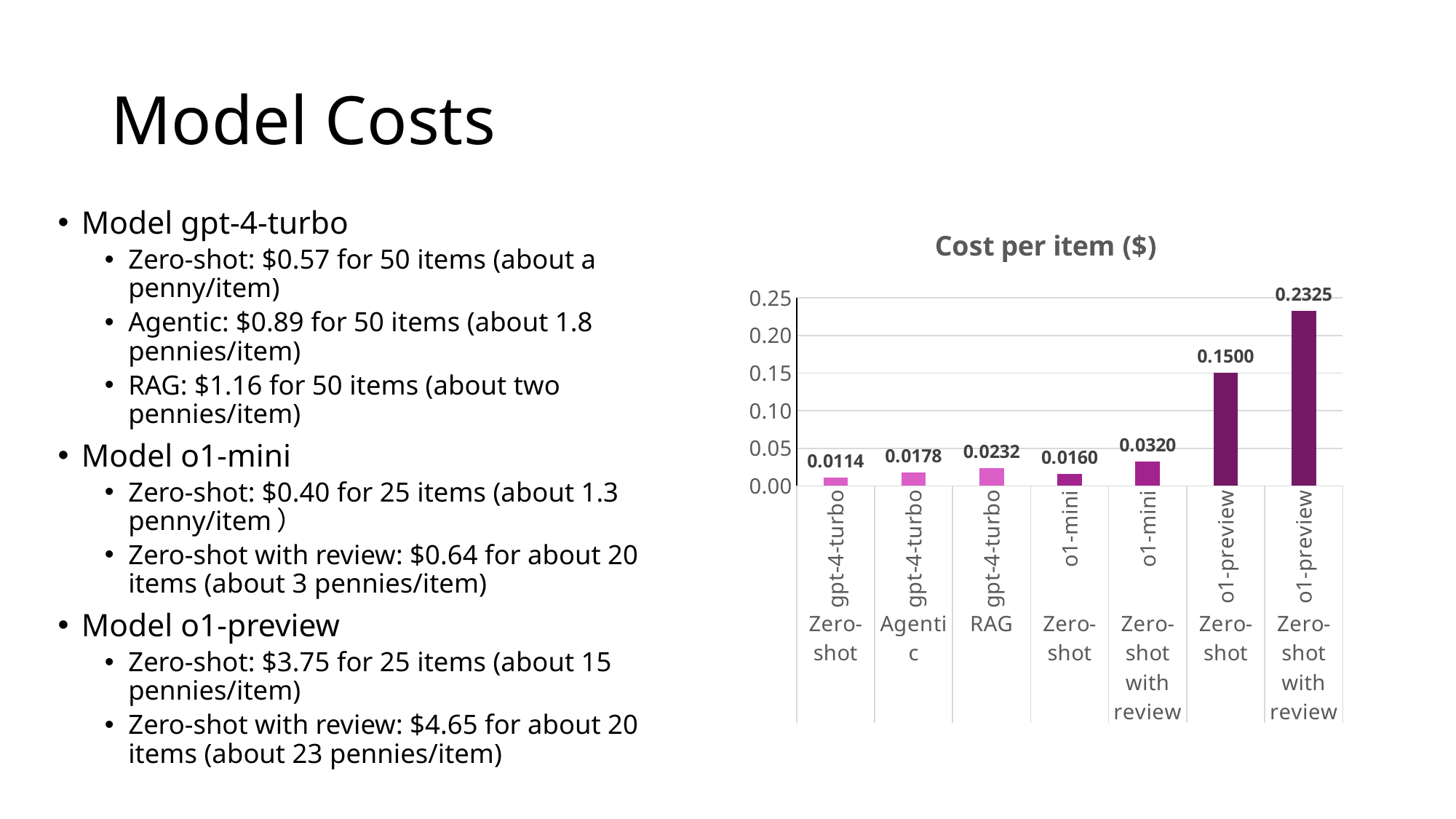
How many bars are shown in the chart? 7 What kind of chart is shown on the slide? bar chart What is the difference in cost per item between o1-preview Zero-shot with review and o1-preview Zero-shot? 0.0825 What is the cost per item for gpt-4-turbo Zero-shot? 0.0114 Which has a higher cost per item: gpt-4-turbo Agentic or o1-mini Zero-shot? gpt-4-turbo Agentic What is the title of the chart? Cost per item ($) Which category has the highest cost per item? o1-preview Zero-shot with review Which category has the lowest cost per item? gpt-4-turbo Zero-shot What is the cost per item for o1-mini Zero-shot with review? 0.0320 What is the cost per item for o1-preview Zero-shot? 0.1500 Is the cost per item for o1-preview Zero-shot with review greater or less than 0.20? greater What is the cost per item for gpt-4-turbo RAG? 0.0232